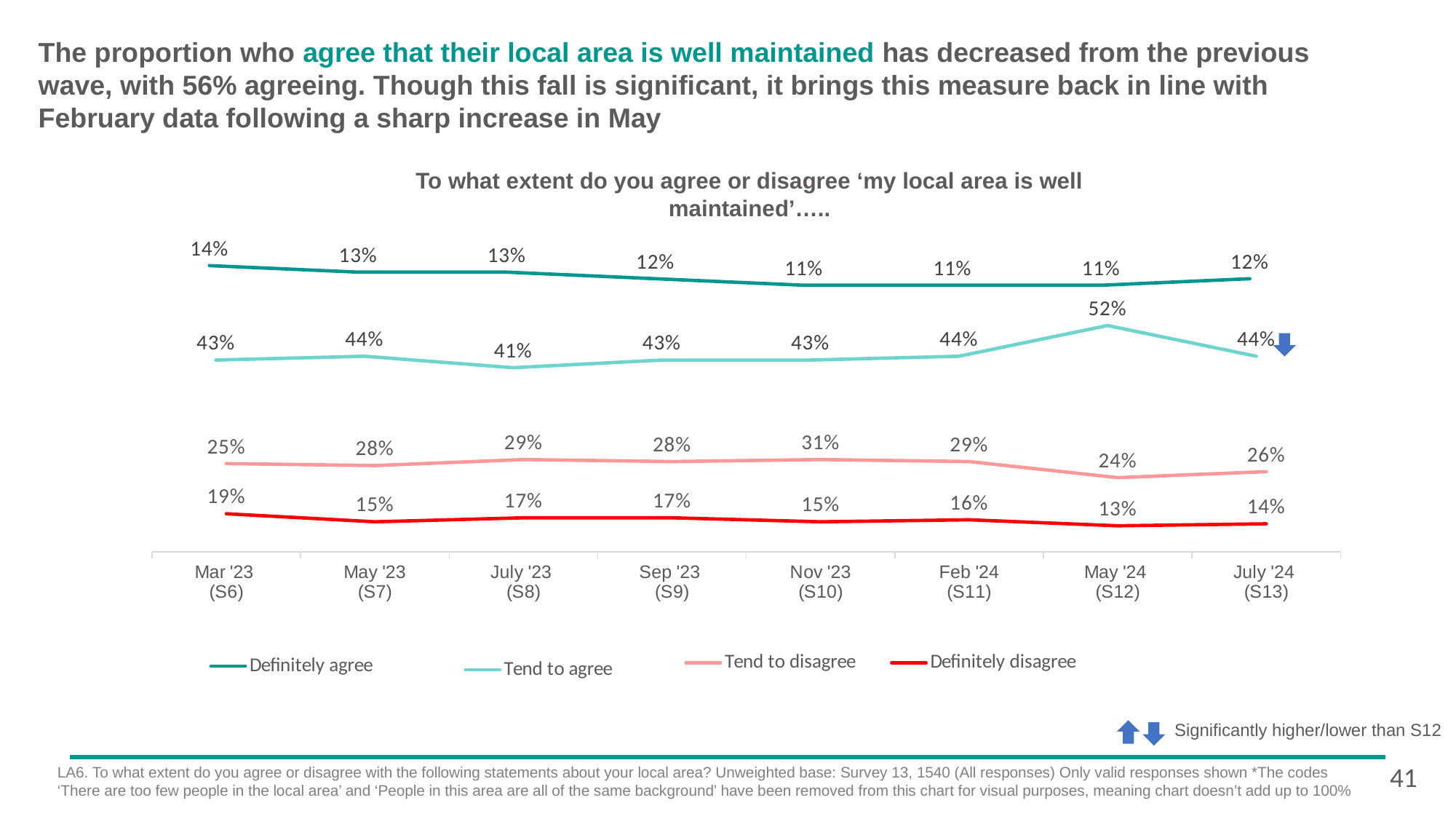
What is the value for Tend to agree in May '24 (S12)? 52% In Mar '23 (S6), which is larger: Tend to disagree or Definitely disagree? Tend to disagree How many series does the legend list? 4 In which wave is Tend to disagree at its highest? Nov '23 (S10) What is the value for Definitely agree in July '24 (S13)? 12% In which wave is Definitely disagree at its lowest? May '24 (S12) By how many percentage points did Tend to agree fall from May '24 (S12) to July '24 (S13)? 8 percentage points What kind of chart is shown on the slide? Line chart What is the difference between Tend to disagree in Nov '23 (S10) and in May '24 (S12)? 7 percentage points What is the value for Definitely disagree in Mar '23 (S6)? 19% How many survey waves are plotted on the x axis? 8 Does the Definitely agree series rise or fall from Mar '23 (S6) to Nov '23 (S10)? Fall